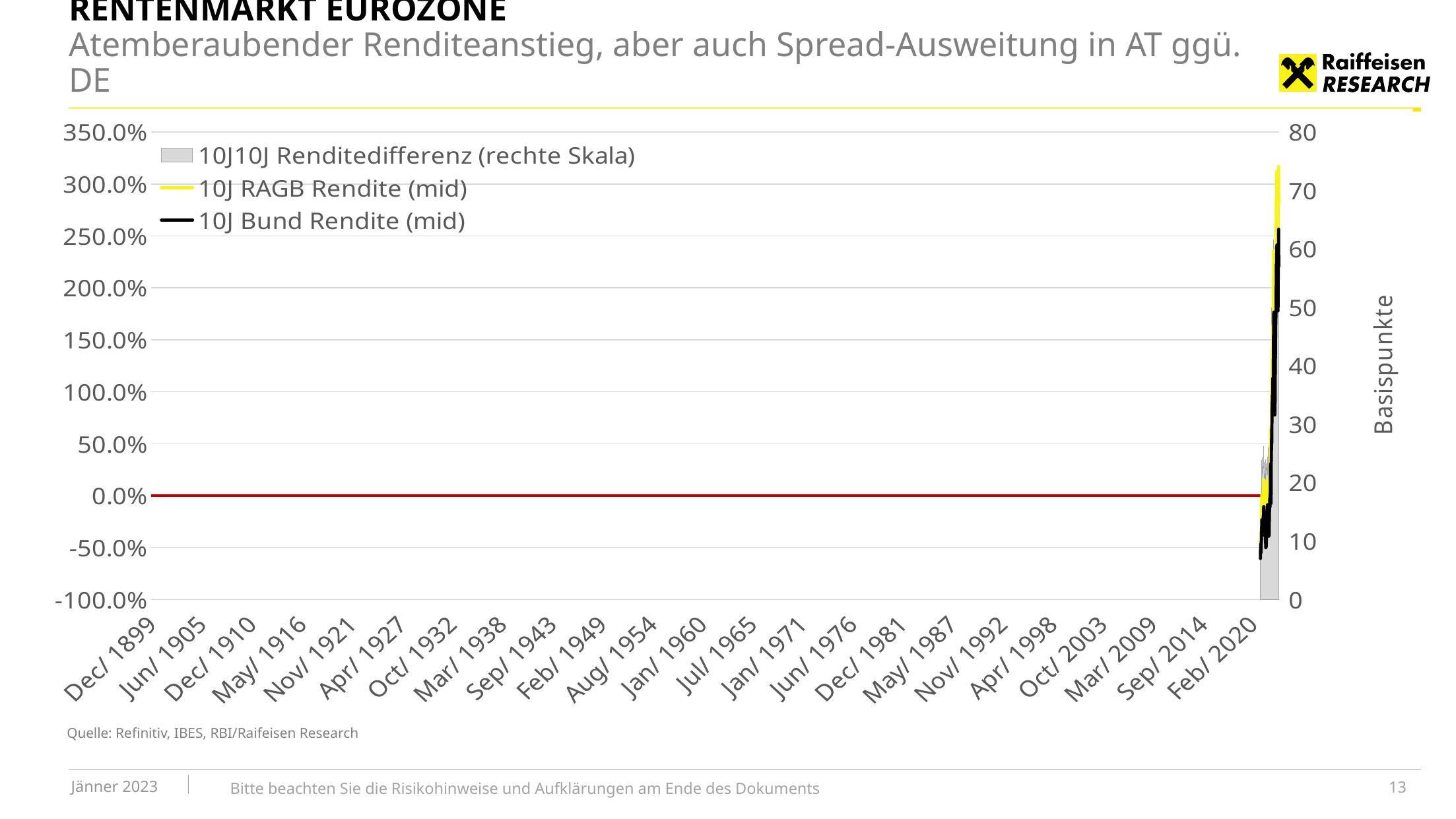
Do the yield lines rise or fall at the right end of the x axis? rise How many series does the legend list? 3 How many date labels are shown on the x axis? 23 Is the peak value of the 10J Bund Rendite (mid) line greater or less than 200.0% on the left axis? greater Which series is plotted on the right scale according to the legend? 10J10J Renditedifferenz What is the highest value shown on the right axis? 80 Is the peak value of the 10J RAGB Rendite (mid) line greater or less than 300.0% on the left axis? greater What kind of chart is this? Combination of line chart and bar chart What is the title of the right-hand axis? Basispunkte What is the highest value shown on the left axis? 350.0% Which line reaches a higher peak, 10J RAGB Rendite (mid) or 10J Bund Rendite (mid)? 10J RAGB Rendite (mid) What is the lowest value shown on the left axis? -100.0%